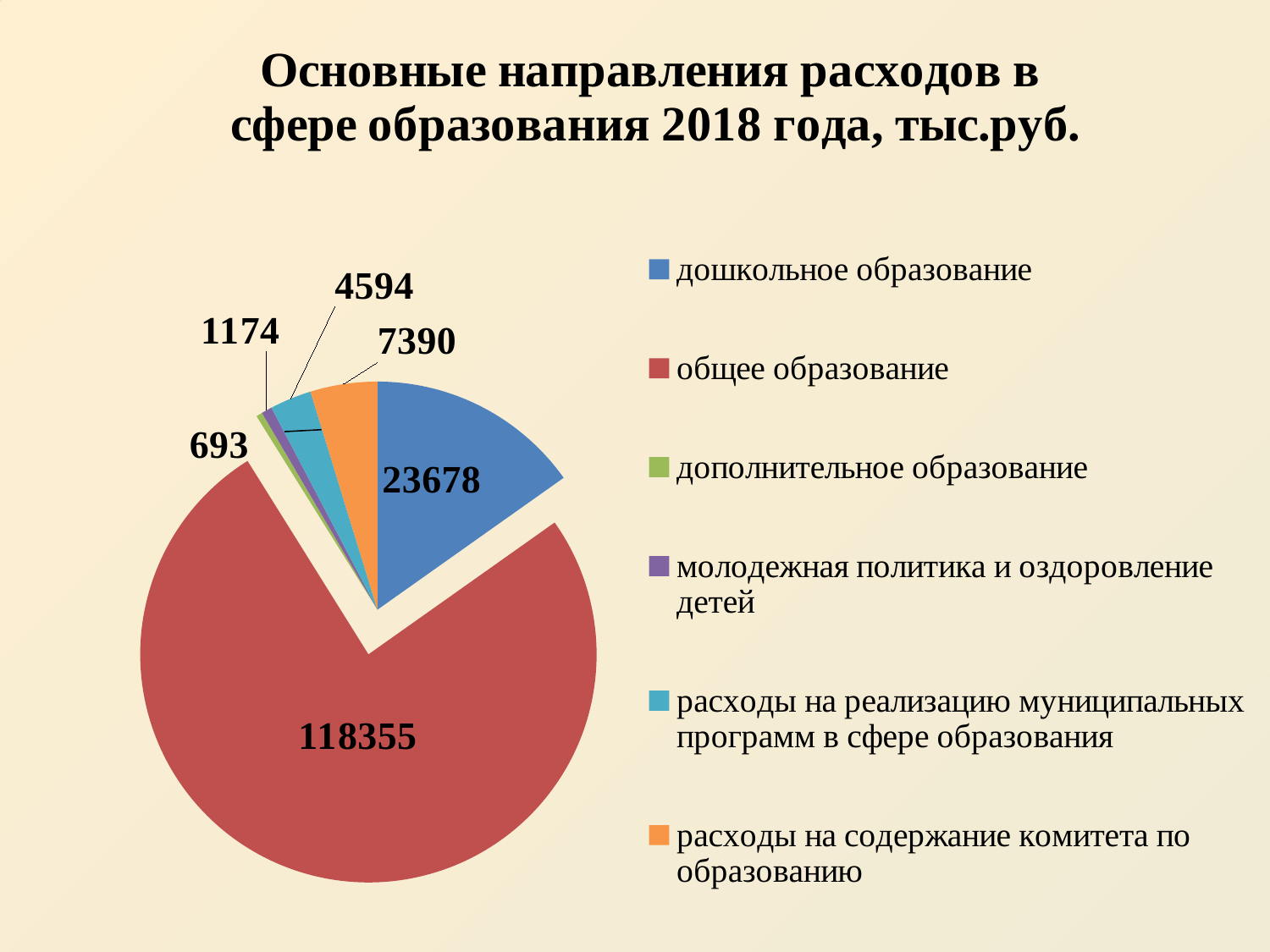
What is the value for расходы на реализацию муниципальных программ в сфере образования? 4594 How many categories does the pie chart show? 6 Which is larger: молодежная политика и оздоровление детей or расходы на реализацию муниципальных программ в сфере образования? расходы на реализацию муниципальных программ в сфере образования What colour is the slice for дошкольное образование? blue What is the value for дополнительное образование? 693 Which category has the largest slice? общее образование What is the difference between общее образование and дошкольное образование? 94677 What is the value for дошкольное образование? 23678 Which category has the smallest slice? дополнительное образование What is the value for расходы на содержание комитета по образованию? 7390 What kind of chart is shown on the slide? pie chart What is the value for общее образование? 118355